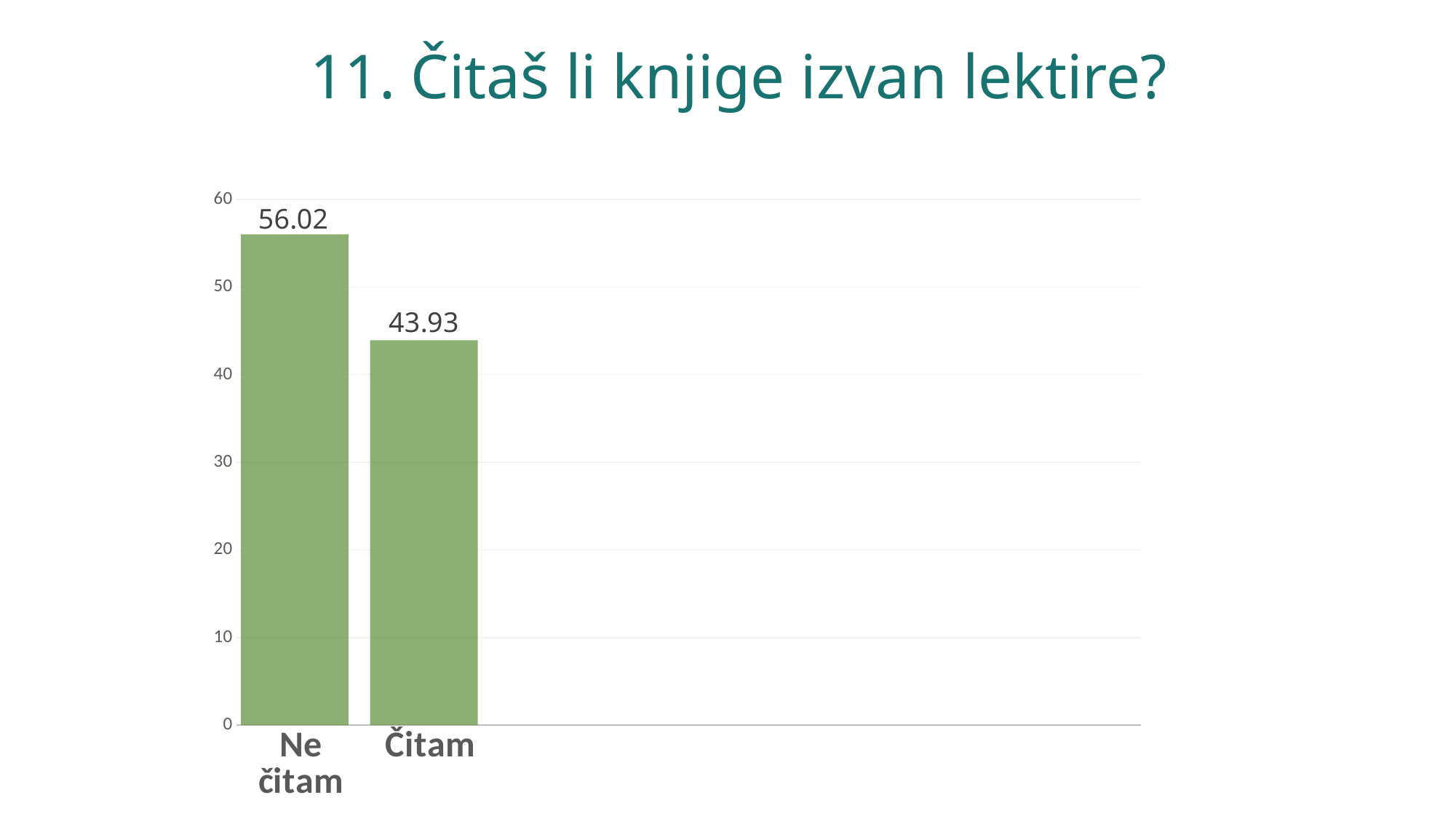
What is the value for "Čitam"? 43.93 Which category has the lowest value? Čitam How many categories are shown on the chart? 2 Which category has the highest value? Ne čitam What is the value for "Ne čitam"? 56.02 Is the value for "Čitam" greater or less than 50? less What is the title of the slide? 11. Čitaš li knjige izvan lektire? What is the highest value shown on the vertical axis? 60 What kind of chart is shown on the slide? bar chart Is the value for "Ne čitam" greater or less than 50? greater Which is larger, the value for "Ne čitam" or the value for "Čitam"? Ne čitam What is the difference between the values for "Ne čitam" and "Čitam"? 12.09